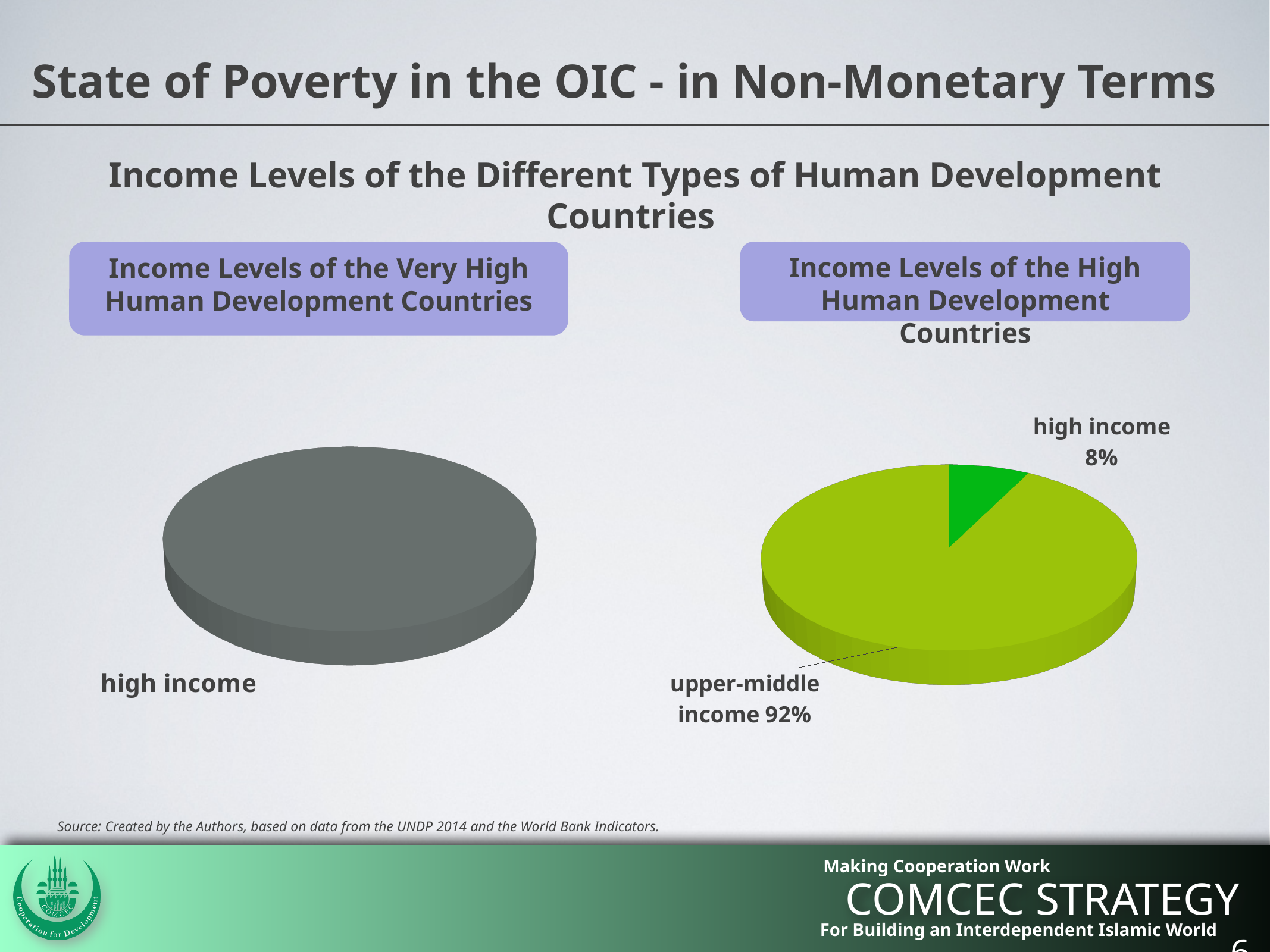
In the 'Income Levels of the High Human Development Countries' chart, what share is labelled for upper-middle income? 92% What is the only category shown in the 'Income Levels of the Very High Human Development Countries' chart? high income In the 'Income Levels of the High Human Development Countries' chart, what share is labelled for high income? 8% What kind of chart is the 'Income Levels of the Very High Human Development Countries' chart? pie chart How many slices does the 'Income Levels of the High Human Development Countries' pie chart have? 2 In the 'Income Levels of the High Human Development Countries' chart, by how many percentage points does upper-middle income exceed high income? 84 percentage points In the 'Income Levels of the High Human Development Countries' chart, which income level has the smallest slice? high income In the 'Income Levels of the High Human Development Countries' chart, what colour is the upper-middle income slice? yellow-green How many slices does the 'Income Levels of the Very High Human Development Countries' pie chart have? 1 In the 'Income Levels of the High Human Development Countries' chart, which is larger: the high income slice or the upper-middle income slice? upper-middle income In the 'Income Levels of the High Human Development Countries' chart, which income level has the largest slice? upper-middle income What kind of chart is the 'Income Levels of the High Human Development Countries' chart? pie chart